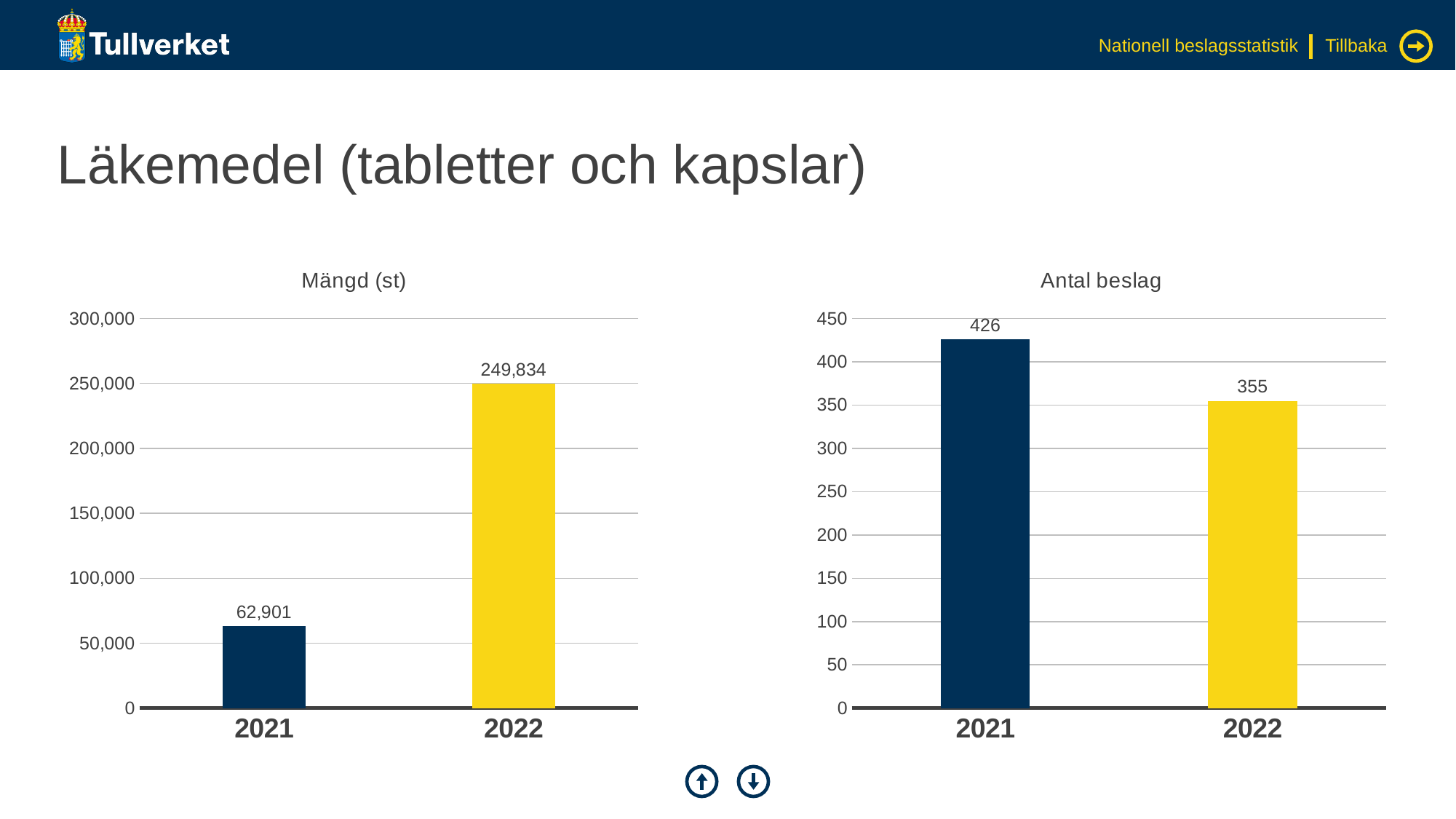
What kind of chart is the 'Antal beslag' chart? bar chart In the 'Antal beslag' chart, what is the value for 2021? 426 In the 'Mängd (st)' chart, what is the difference between the 2022 and 2021 values? 186,933 In the 'Mängd (st)' chart, what is the value for 2022? 249,834 In the 'Antal beslag' chart, what is the difference between the 2021 and 2022 values? 71 In the 'Antal beslag' chart, is the value for 2021 greater or less than 400? greater In the 'Mängd (st)' chart, which year has the highest value? 2022 In the 'Antal beslag' chart, what is the value for 2022? 355 How many years are shown in the 'Mängd (st)' chart? 2 In the 'Mängd (st)' chart, what is the value for 2021? 62,901 In the 'Mängd (st)' chart, do the values rise or fall from 2021 to 2022? rise In the 'Antal beslag' chart, which year has the lowest value? 2022